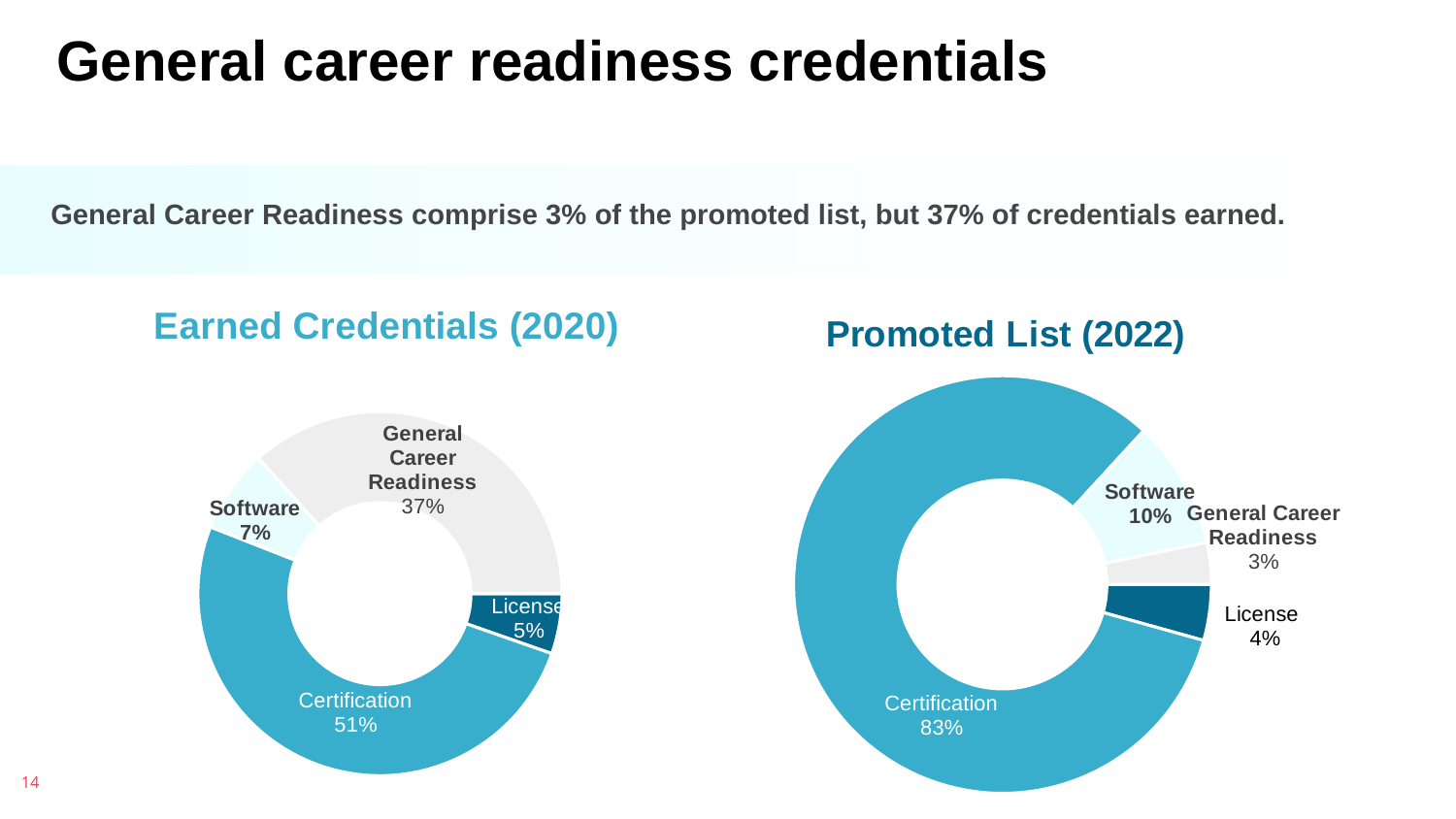
In the Promoted List (2022) chart, what share is Certification? 83% In the Earned Credentials (2020) chart, what share is Software? 7% In the Earned Credentials (2020) chart, what share is General Career Readiness? 37% What is the title of the chart on the left of the slide? Earned Credentials (2020) In the Earned Credentials (2020) chart, which category has the largest share? Certification In the Promoted List (2022) chart, which category has the smallest share? General Career Readiness What is the difference between the Certification share in the Promoted List (2022) chart and the Certification share in the Earned Credentials (2020) chart? 32% In the Promoted List (2022) chart, what share is License? 4% In the Earned Credentials (2020) chart, which category has the smallest share? License In the Promoted List (2022) chart, which is larger: Software or License? Software How many categories does the Earned Credentials (2020) chart show? 4 What kind of chart is the Promoted List (2022) chart? Doughnut (pie) chart